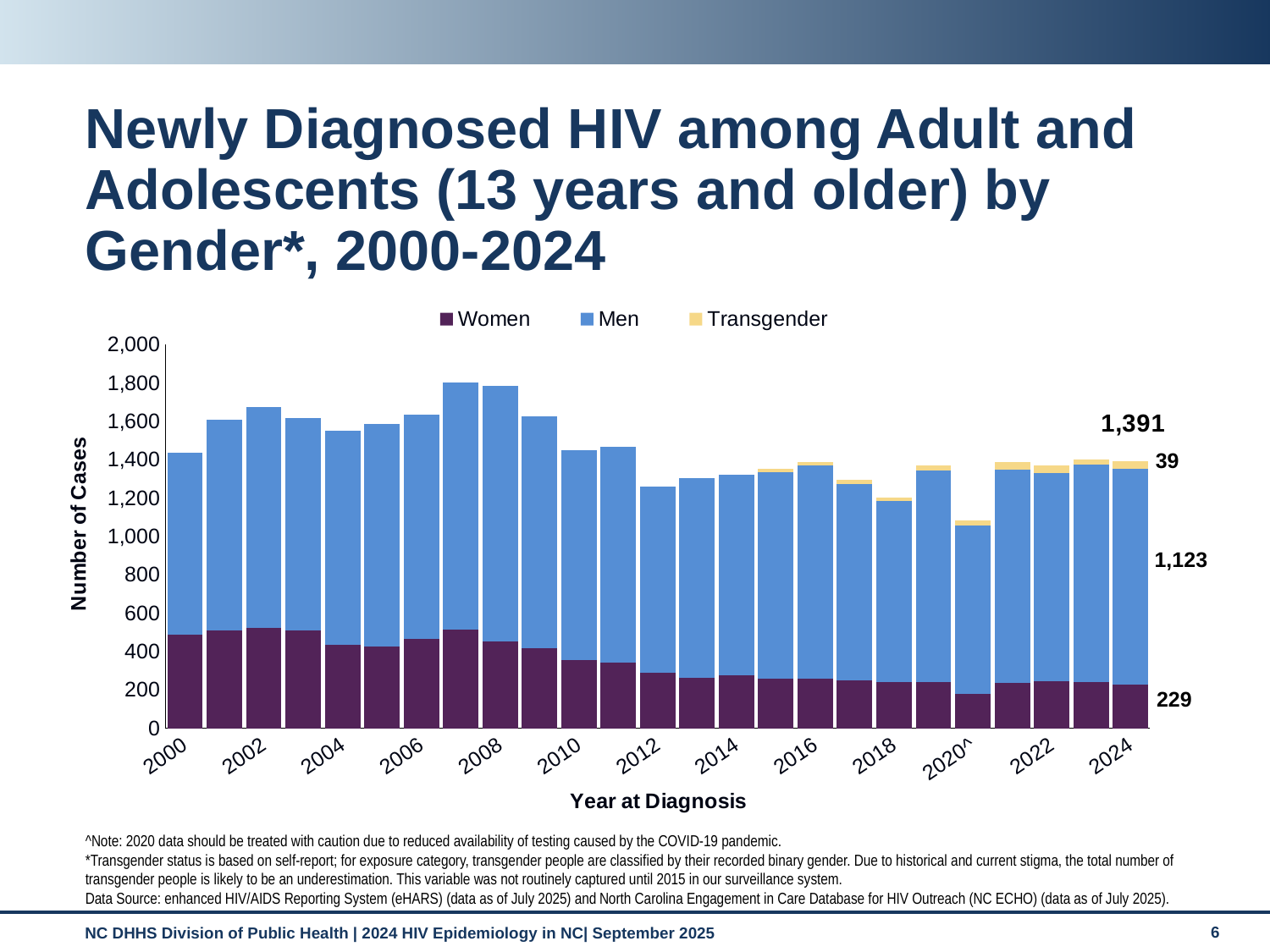
What is the number of newly diagnosed HIV cases among women in 2024? 229 What is the number of newly diagnosed HIV cases among men in 2024? 1,123 In 2024, how many more cases were diagnosed among men than among women? 894 What kind of chart is shown on the slide? Stacked bar chart Is the total number of cases in 2020 greater or less than 1,200? less Which year has the larger total number of cases, 2007 or 2012? 2007 What is the number of newly diagnosed HIV cases among transgender people in 2024? 39 What is the title of the vertical axis? Number of Cases Which year has the lowest total number of cases? 2020 What is the total number of newly diagnosed HIV cases in 2024? 1,391 How many years (bars) are plotted on the chart? 25 How many series does the legend list? 3